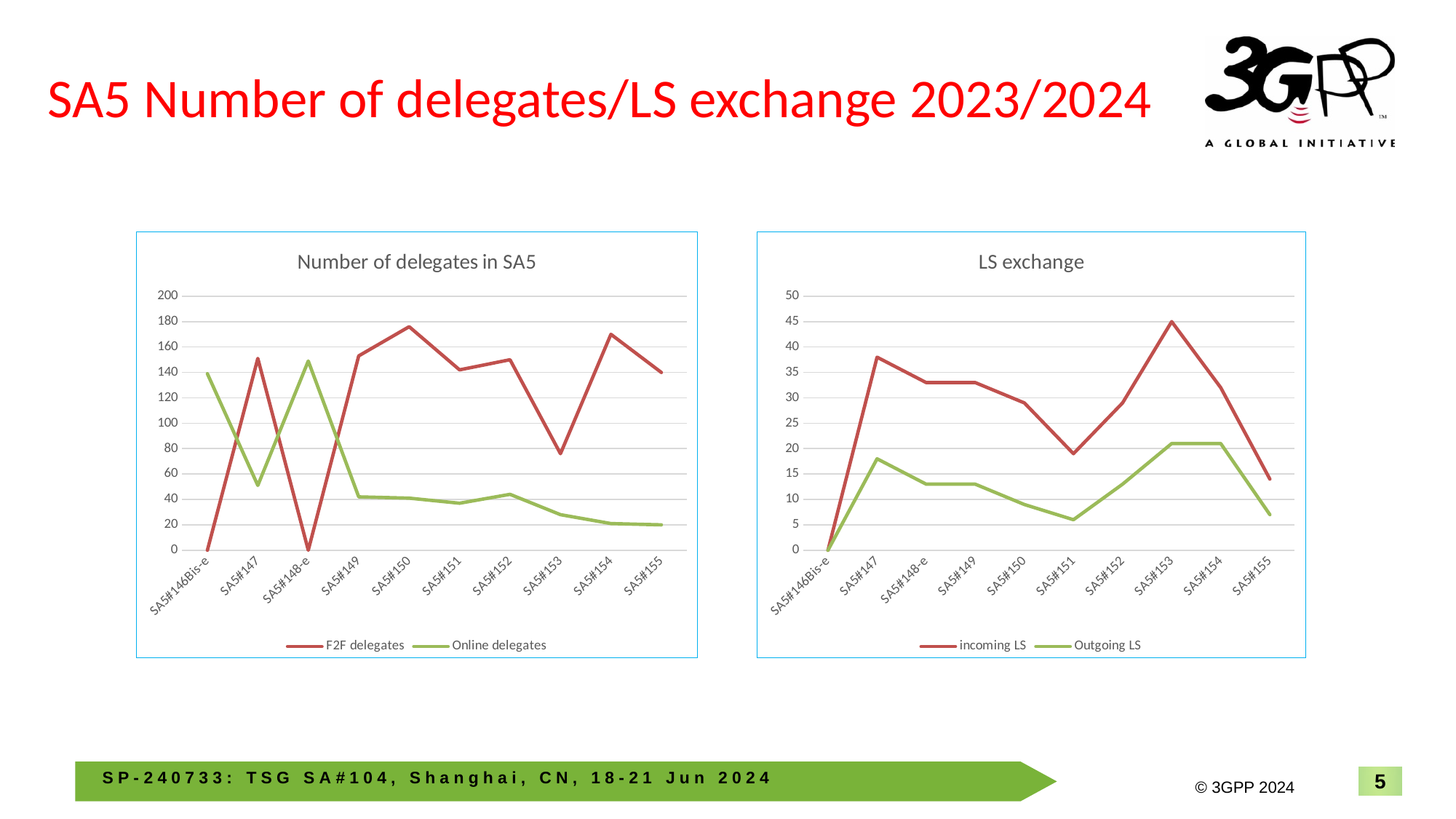
In the 'LS exchange' chart, which is larger at SA5#150: incoming LS or Outgoing LS? incoming LS How many meetings are shown on the x axis of the 'Number of delegates in SA5' chart? 10 In the 'LS exchange' chart, is the value for Outgoing LS at SA5#147 greater or less than 20? less In the 'LS exchange' chart, at which meeting is incoming LS highest? SA5#153 What kind of chart is the 'Number of delegates in SA5' chart? line chart In the 'LS exchange' chart, what is the value of incoming LS at SA5#153? 45 How many series does the legend of the 'LS exchange' chart list? 2 In the 'Number of delegates in SA5' chart, do Online delegates rise or fall from SA5#149 to SA5#155? fall What is the title of the chart on the right of the slide? LS exchange In the 'Number of delegates in SA5' chart, what is the value of Online delegates at SA5#155? 20 In the 'Number of delegates in SA5' chart, is the value for F2F delegates at SA5#150 greater or less than 160? greater In the 'Number of delegates in SA5' chart, what is the value of F2F delegates at SA5#148-e? 0